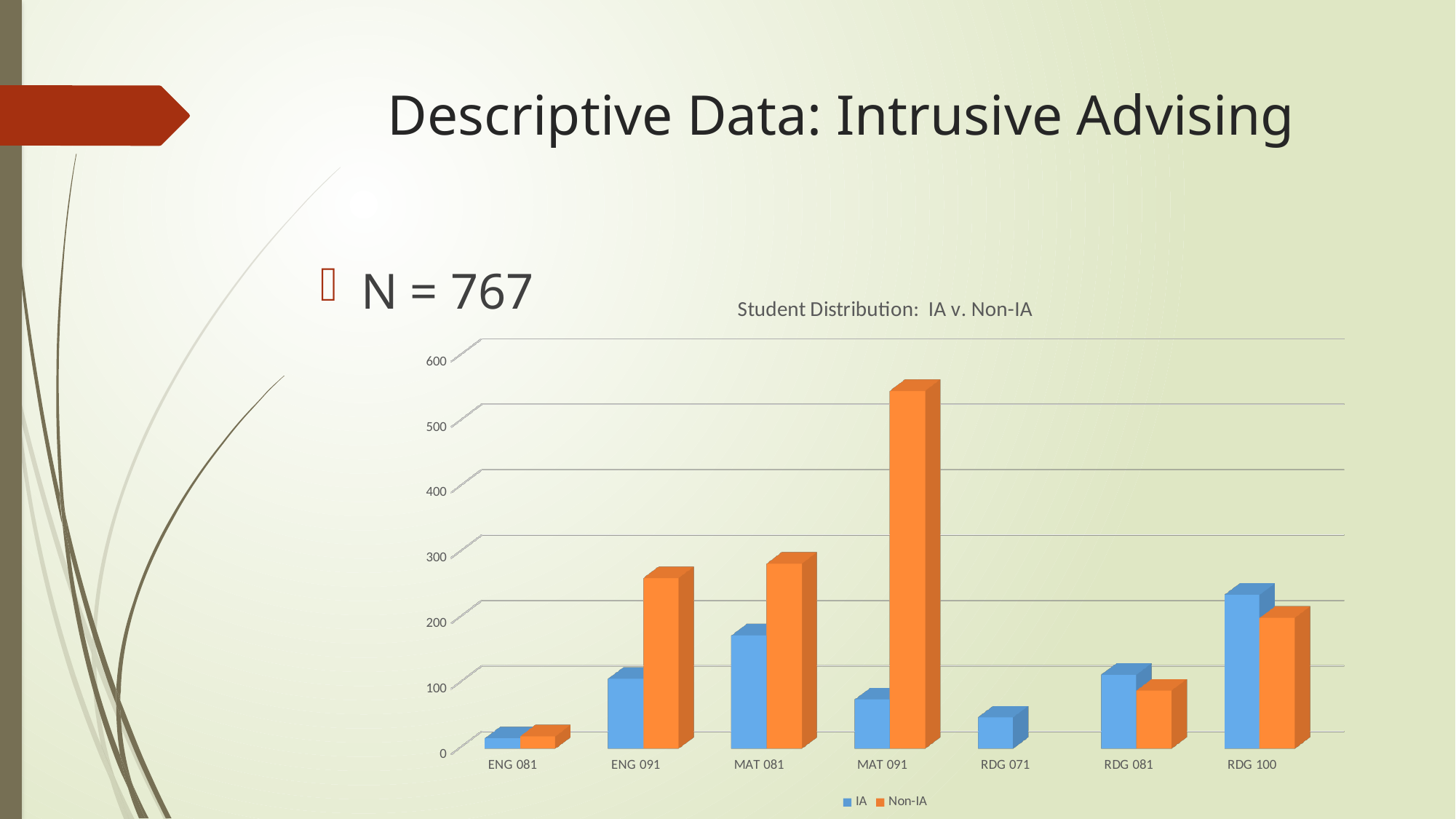
For MAT 081, which is larger, the IA value or the Non-IA value? Non-IA What is the title of the chart? Student Distribution: IA v. Non-IA How many course categories are shown on the x axis of the chart? 7 Is the IA value for ENG 091 greater or less than 200? less Which category has the lowest IA value? ENG 081 Is the Non-IA value for ENG 091 greater or less than 200? greater Which category has the highest IA value? RDG 100 Is the Non-IA value for MAT 091 greater or less than 500? greater Which category has the highest Non-IA value? MAT 091 How many series does the chart's legend list? 2 What kind of chart is shown on the slide? bar chart Which colour represents the Non-IA series in the chart? orange